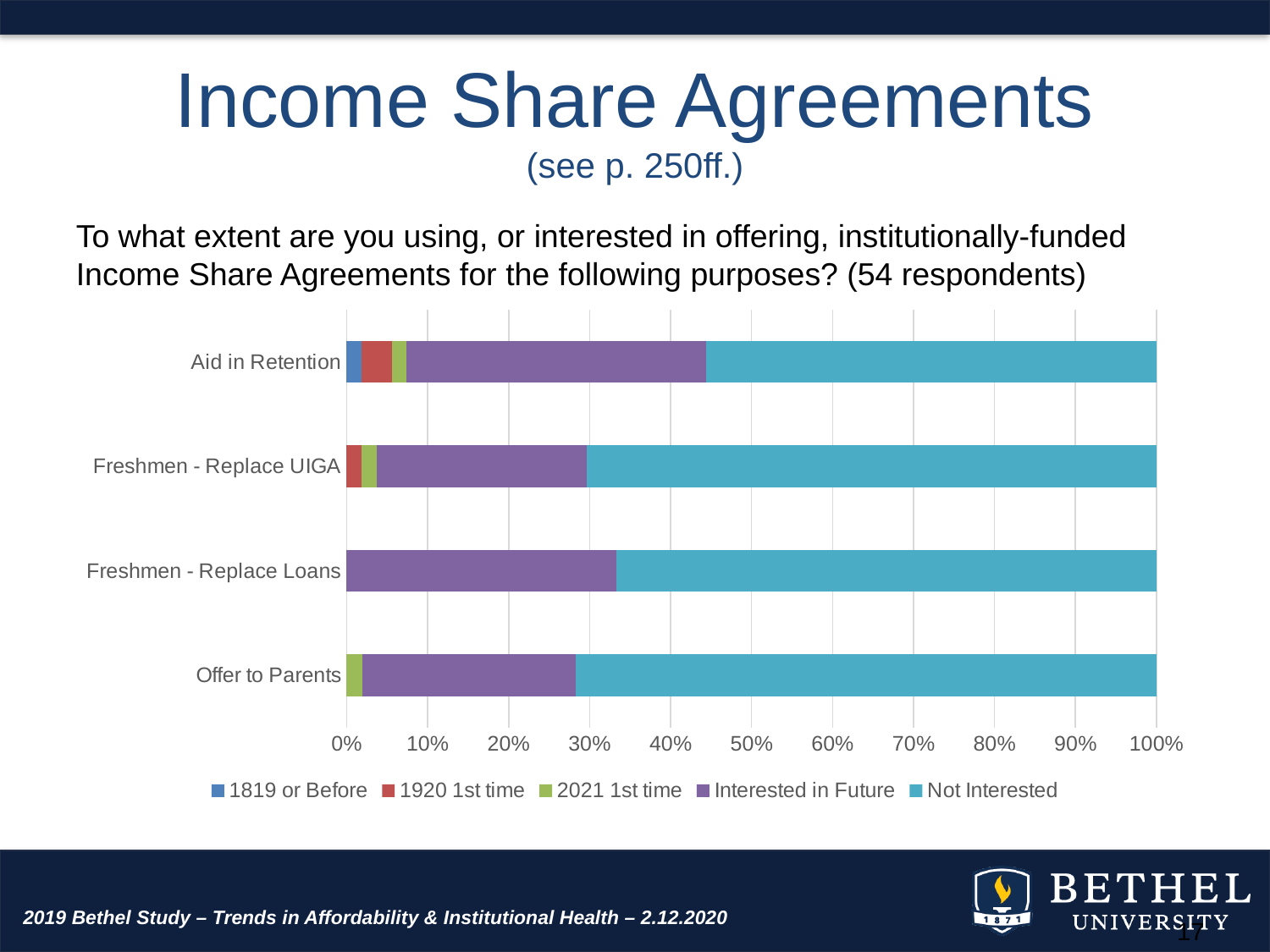
Which series is shown in purple in the legend? Interested in Future Is the Interested in Future share for Aid in Retention greater or less than 30%? greater Is the Not Interested share for Aid in Retention greater or less than 50%? greater Is the Interested in Future share for Freshmen - Replace Loans greater or less than 40%? less Which category is the only one with a 1819 or Before segment? Aid in Retention Which series is listed first in the legend? 1819 or Before Which category has the larger Interested in Future share, Aid in Retention or Offer to Parents? Aid in Retention How many purposes (categories) are plotted on the chart? 4 What kind of chart is shown on the slide? Stacked bar chart How many series does the legend list? 5